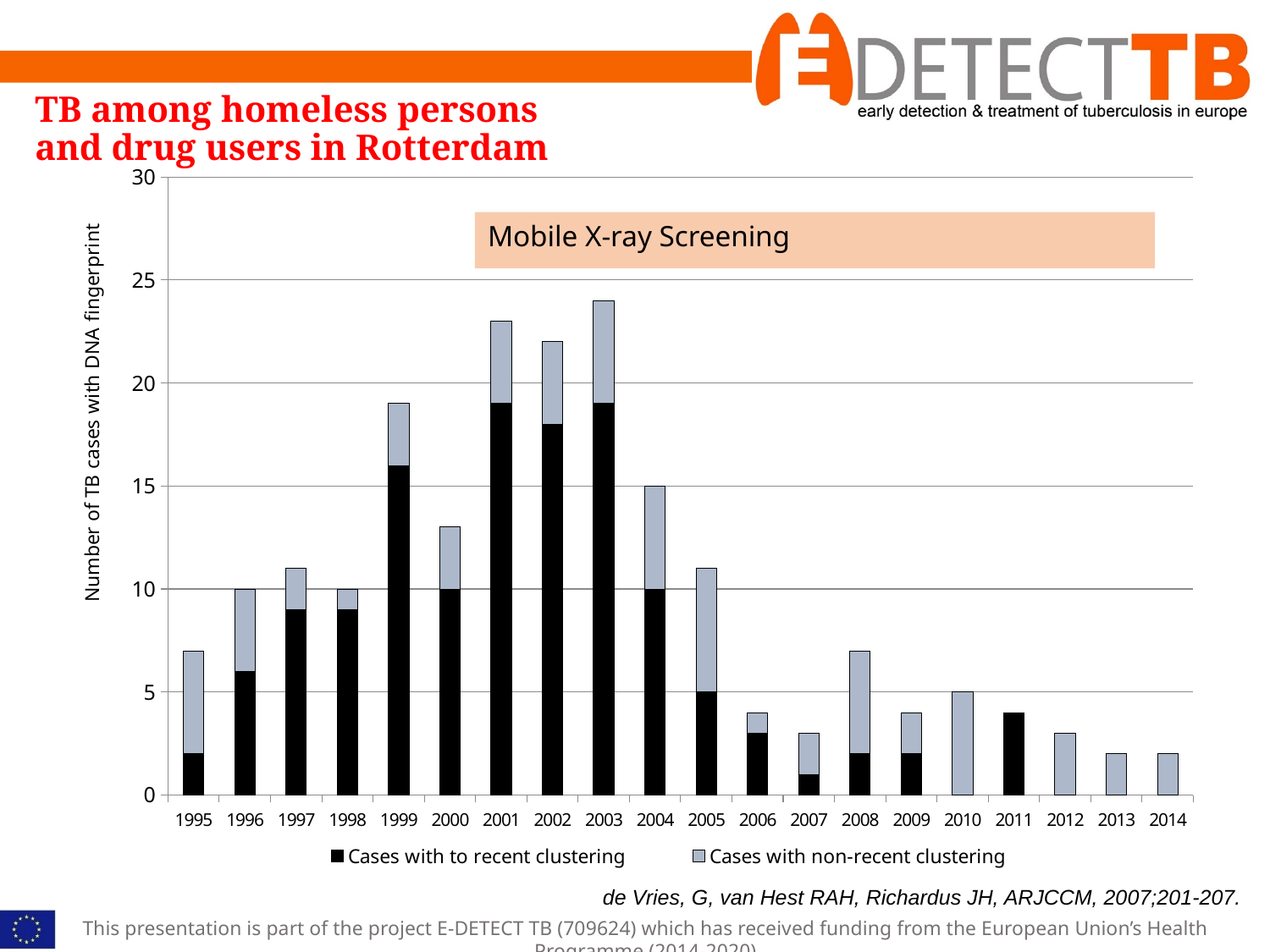
Is the total value for 2003 greater or less than 20? greater What is the total number of TB cases for 2010? 5 Is the total value for 2007 greater or less than 5? less How many cases with recent clustering are shown for 2005? 5 What is the total number of TB cases for 2004? 15 What is the label on the y axis? Number of TB cases with DNA fingerprint Which year has a higher total number of cases, 2001 or 2005? 2001 How many years are shown on the x axis? 20 How many series does the legend list? 2 What is the total number of TB cases for 1996? 10 Do the total values rise or fall from 2003 to 2014? Fall What kind of chart is shown on the slide? Stacked bar chart